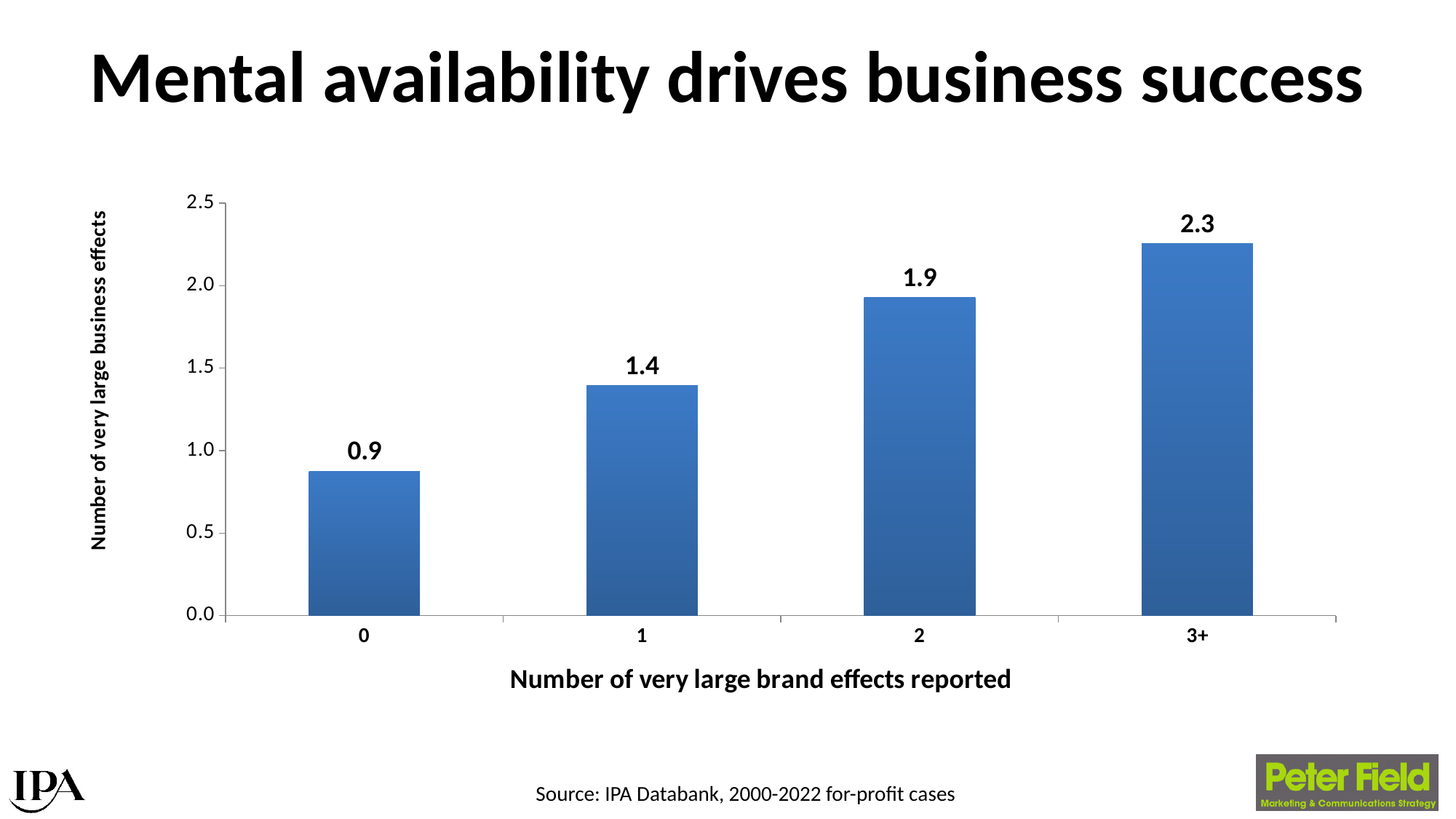
Which has more very large business effects: 1 or 2 very large brand effects reported? 2 How many categories are shown on the x axis? 4 Which category has the highest number of very large business effects? 3+ What is the number of very large business effects for 0 very large brand effects reported? 0.9 What is the number of very large business effects for 2 very large brand effects reported? 1.9 What is the difference in very large business effects between the 3+ and 0 categories? 1.4 What kind of chart is shown on the slide? Bar chart Is the value for the 2 category greater or less than 1.5? greater What is the number of very large business effects for 1 very large brand effect reported? 1.4 Do the values rise or fall as the number of very large brand effects reported increases? Rise What is the number of very large business effects for 3+ very large brand effects reported? 2.3 Which category has the lowest number of very large business effects? 0